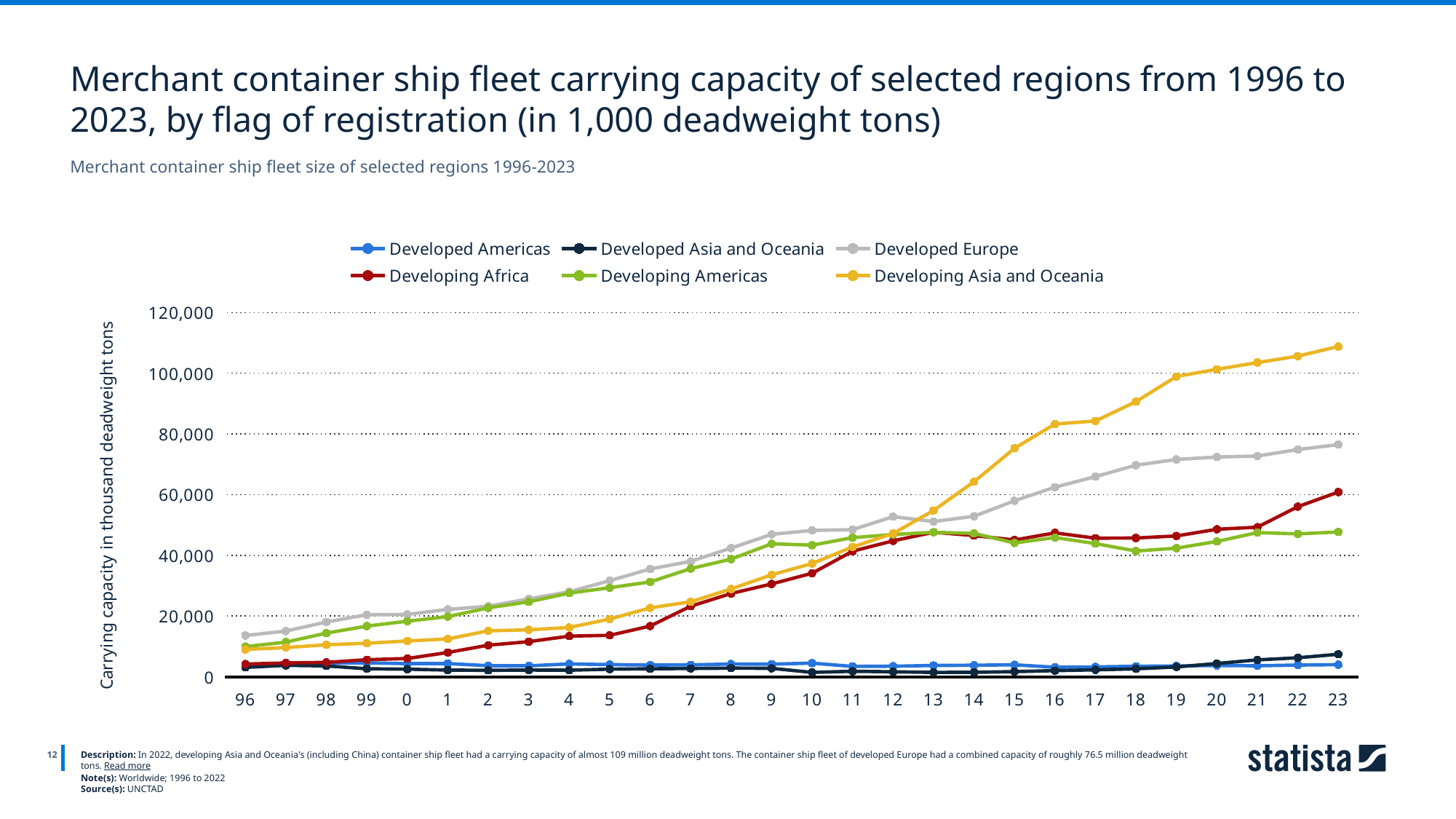
Does the carrying capacity of Developing Asia and Oceania rise or fall from 96 to 23? rise Which region has the lowest carrying capacity in 23? Developed Americas Is the value for Developing Asia and Oceania in 23 greater or less than 100,000? greater Which is larger in 23, Developed Europe or Developing Africa? Developed Europe Is the value for Developing Africa in 23 greater or less than 40,000? greater Is the value for Developing Americas in 23 greater or less than 60,000? less What is the label on the y axis? Carrying capacity in thousand deadweight tons How many series does the legend list? 6 How many years are plotted along the x axis? 28 What kind of chart is shown on the slide? line chart Which region has the highest carrying capacity in 23? Developing Asia and Oceania